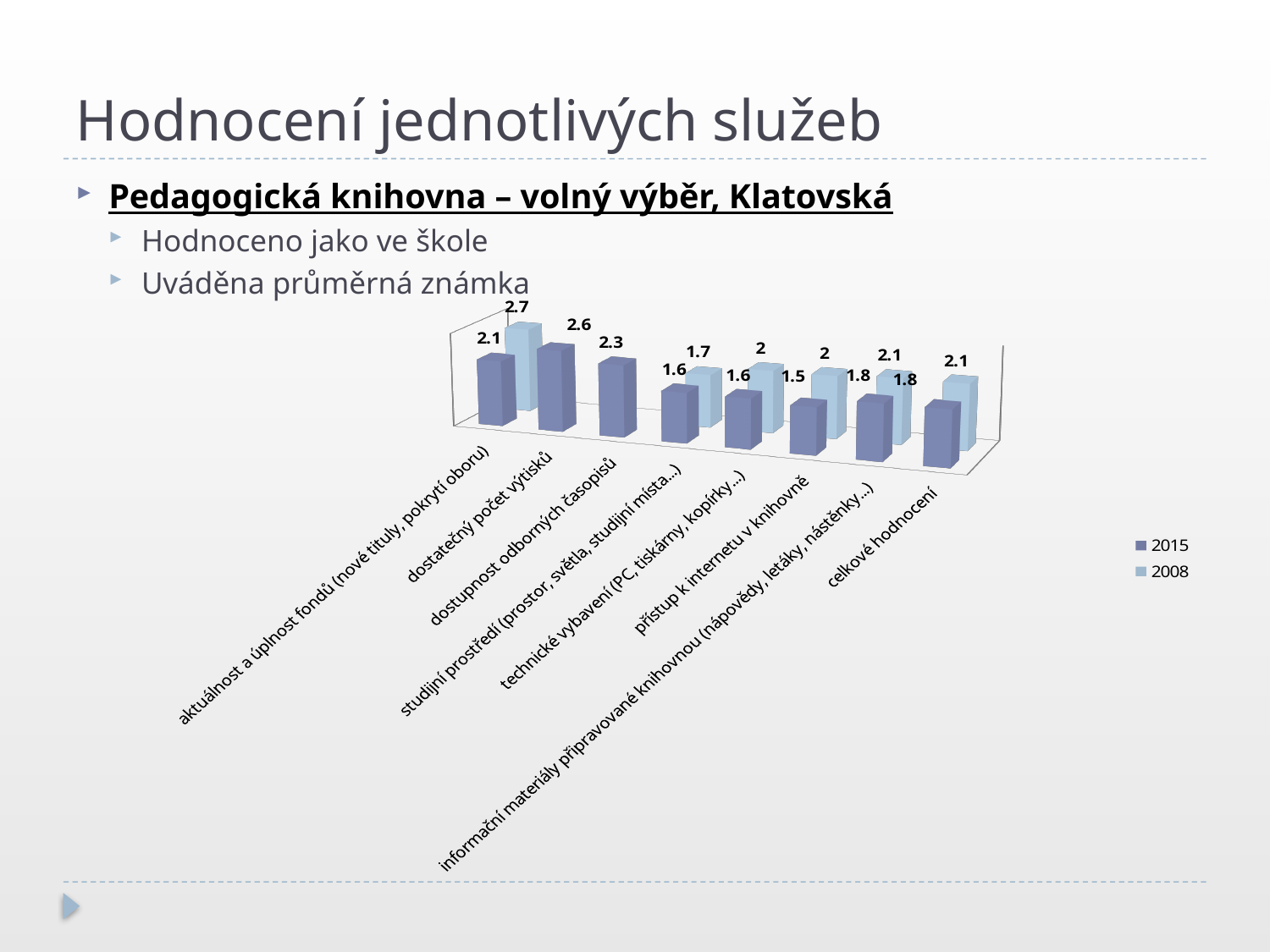
What is the 2015 value for 'přístup k internetu v knihovně'? 1.5 For 'technické vybavení (PC, tiskárny, kopírky...)', which is larger: the 2015 value or the 2008 value? 2008 Which category has the highest 2015 value? dostatečný počet výtisků What is the difference between the 2008 and 2015 values for 'aktuálnost a úplnost fondů (nové tituly, pokrytí oboru)'? 0.6 What kind of chart is shown on the slide? bar chart What is the 2008 value for 'aktuálnost a úplnost fondů (nové tituly, pokrytí oboru)'? 2.7 Which two series are listed in the chart legend? 2015 and 2008 Which category has the lowest 2015 value? přístup k internetu v knihovně What is the 2015 value for 'dostatečný počet výtisků'? 2.6 What is the 2008 value for 'celkové hodnocení'? 2.1 How many series does the chart legend list? 2 How many categories are shown on the chart's x axis? 8